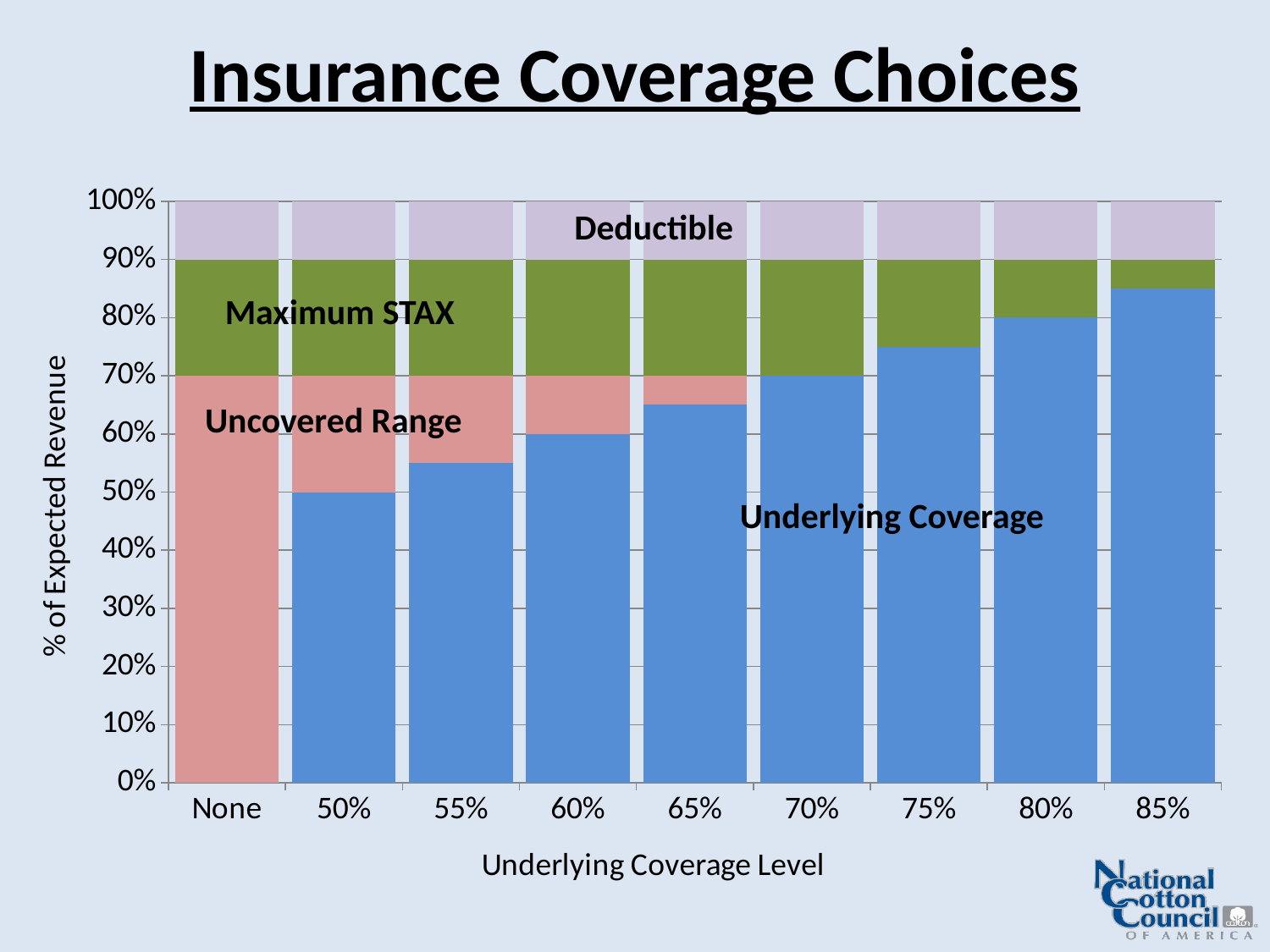
What is the Uncovered Range value for the None category? 70% What kind of chart is shown on the slide? Stacked bar chart How many underlying coverage level categories are shown on the x axis? 9 What is the Underlying Coverage value for the 50% coverage level? 50% Which category has the largest Uncovered Range segment? None What is the label on the y axis of the chart? % of Expected Revenue Does the Underlying Coverage segment rise or fall as the coverage level increases along the x axis? Rises What is the Underlying Coverage value for the 80% coverage level? 80% Which coverage level has the largest Underlying Coverage segment? 85% What is the difference between the Underlying Coverage values at the 80% and 50% coverage levels? 30% Is the Underlying Coverage value for the 85% coverage level greater or less than 80%? greater Is the Uncovered Range segment for the 65% coverage level greater or less than 10%? less